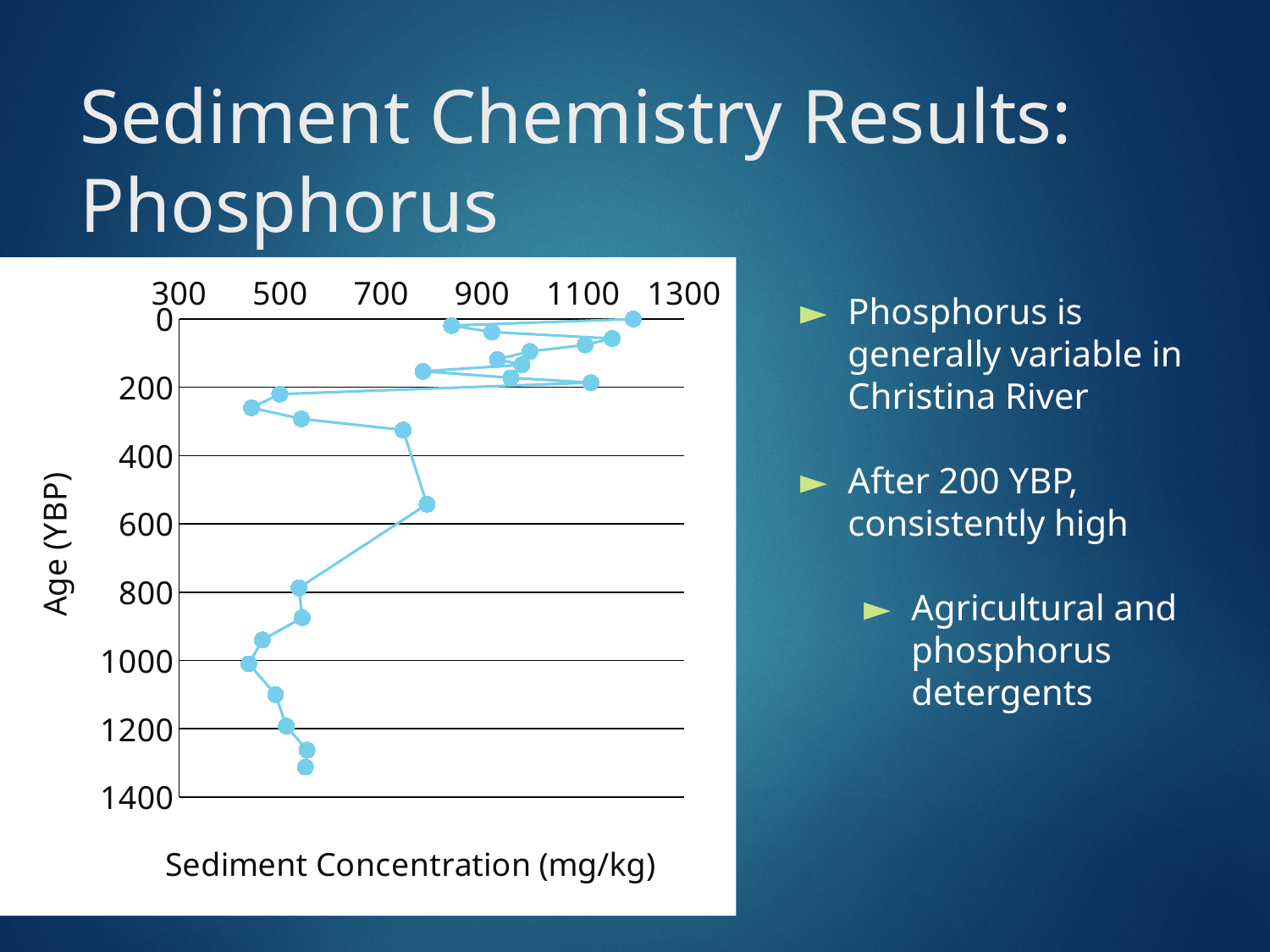
What kind of chart is shown on the slide? Line chart with markers (scatter plot) Is the sediment concentration at age 0 YBP greater or less than 1100 mg/kg? greater Are sediment concentrations generally higher for ages younger than 200 YBP or for ages older than 800 YBP? Younger than 200 YBP Is the sediment concentration at roughly 1000 YBP greater or less than 500 mg/kg? less Is the sediment concentration at roughly 260 YBP greater or less than 500 mg/kg? less What is the title of the vertical axis of the chart? Age (YBP) Which has the higher sediment concentration: the point at 0 YBP or the point at roughly 1000 YBP? 0 YBP At which age does the highest sediment concentration occur? 0 YBP What is the title of the horizontal axis of the chart? Sediment Concentration (mg/kg) What is the maximum value shown on the horizontal axis? 1300